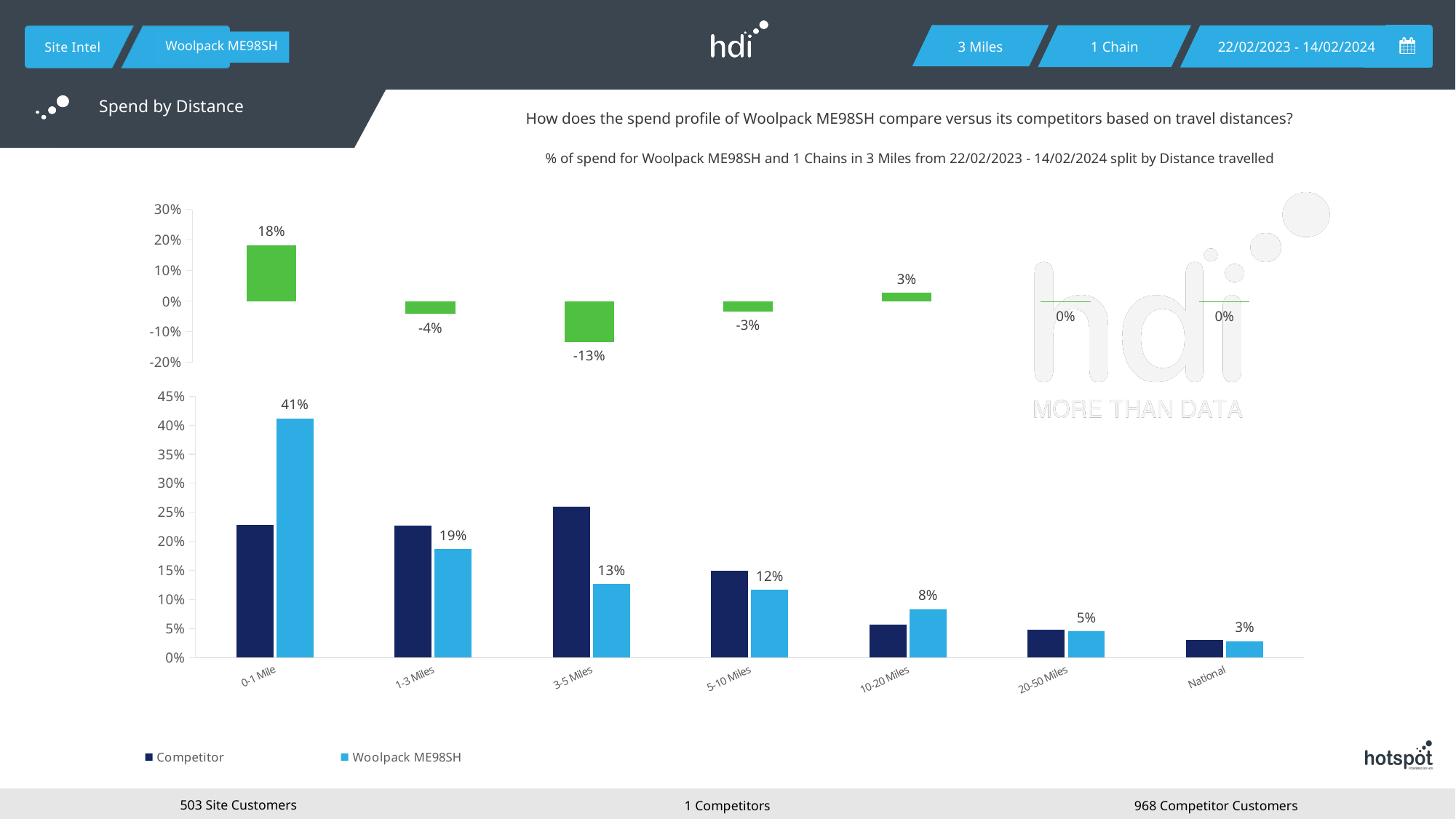
In the bottom chart, which distance band has the lowest Woolpack ME98SH value? National In the bottom chart, is the Competitor value for 10-20 Miles greater or less than 10%? less In the bottom chart, which distance band has the highest Woolpack ME98SH value? 0-1 Mile In the top chart, what is the value for 3-5 Miles? -13% In the bottom chart, which is larger for 3-5 Miles: Competitor or Woolpack ME98SH? Competitor In the top chart, which distance band has the lowest value? 3-5 Miles In the bottom chart, what is the difference between the Woolpack ME98SH values for 0-1 Mile and 1-3 Miles? 22 percentage points How many distance bands are shown on the x axis of the bottom chart? 7 In the bottom chart, is the Competitor value for 3-5 Miles greater or less than 20%? greater In the bottom chart, what is the Woolpack ME98SH value for 0-1 Mile? 41% In the bottom chart, what is the Woolpack ME98SH value for 10-20 Miles? 8% How many series does the legend of the bottom chart list? 2